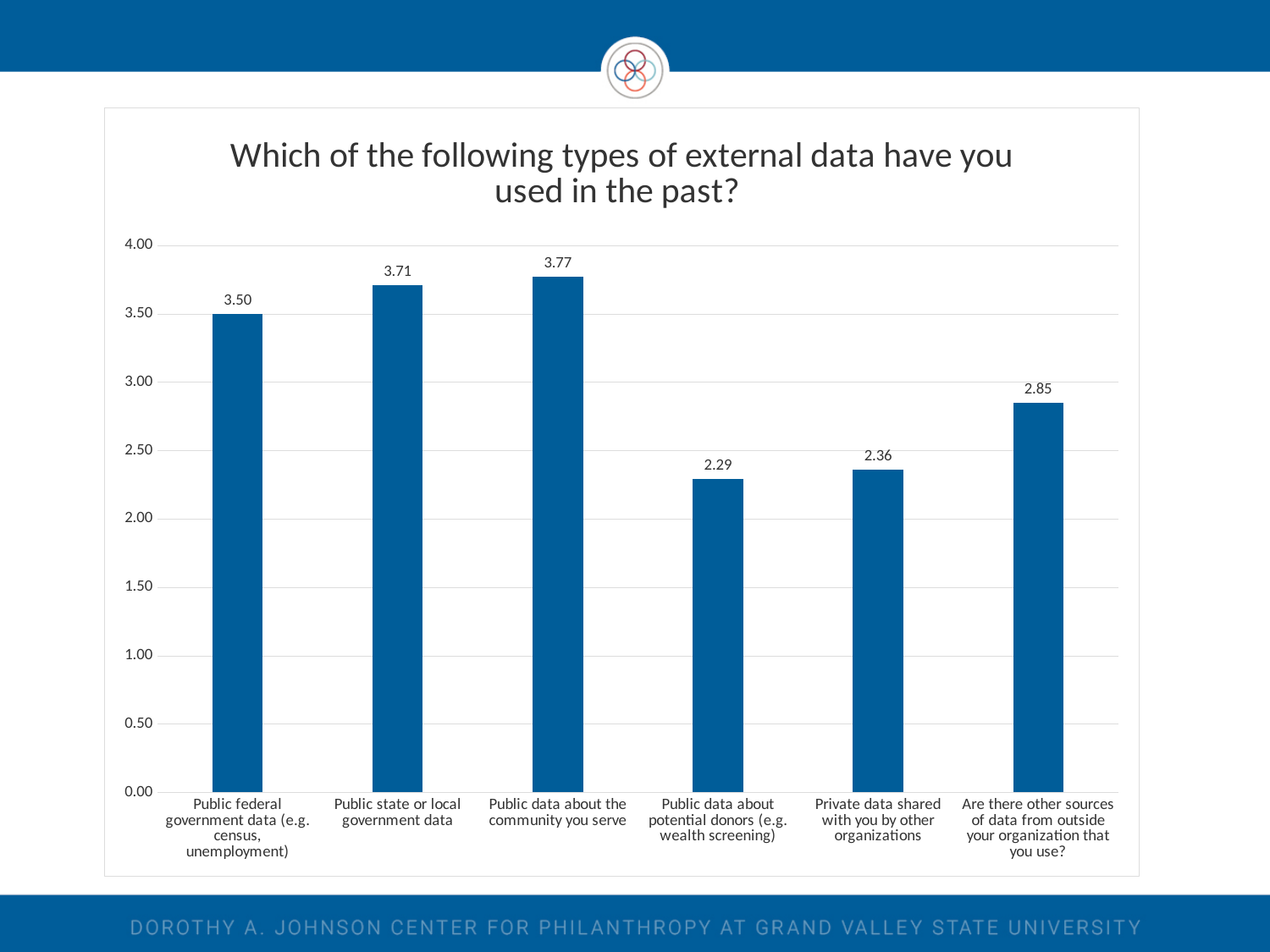
What is the difference between the values for Public state or local government data and Public federal government data? 0.21 What is the title of the chart? Which of the following types of external data have you used in the past? How many categories are shown in the chart? 6 What is the value for Public data about potential donors (e.g. wealth screening)? 2.29 Which category has the lowest value? Public data about potential donors (e.g. wealth screening) What is the value for Public federal government data (e.g. census, unemployment)? 3.50 Is the value for Are there other sources of data from outside your organization that you use? greater or less than 3.00? less What is the maximum value shown on the vertical axis? 4.00 What is the value for Private data shared with you by other organizations? 2.36 What kind of chart is shown on the slide? Bar chart Which is larger: the value for Public federal government data or the value for Are there other sources of data from outside your organization that you use? Public federal government data Which category has the highest value? Public data about the community you serve